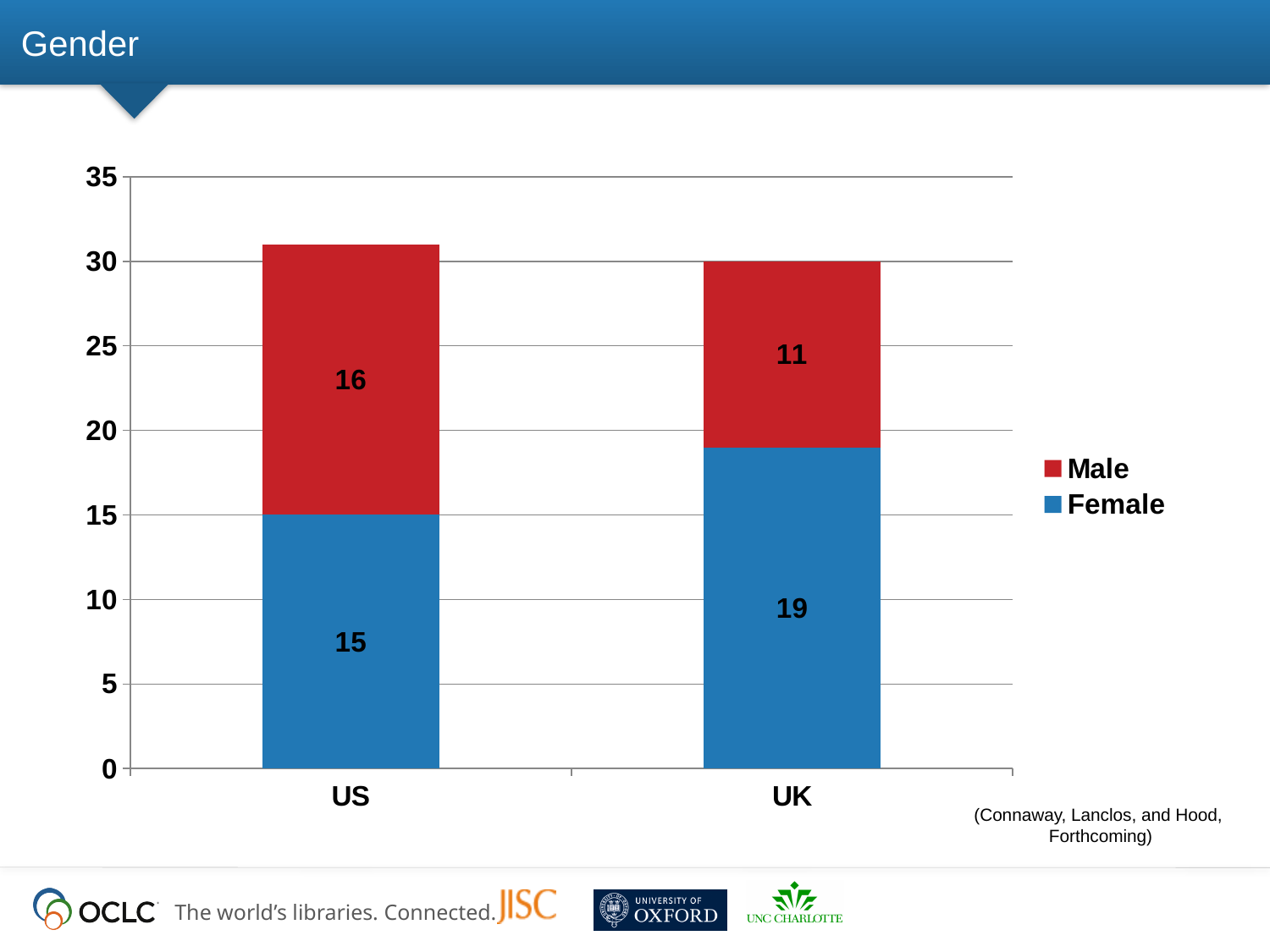
Which category has the lower Male value? UK How many series does the legend list? 2 What is the difference between the Male values for US and UK? 5 What kind of chart is shown on the slide? Stacked bar chart What is the total of the stacked bar for US? 31 What is the Male value for UK? 11 What is the total of the stacked bar for UK? 30 What is the Male value for US? 16 How many categories are shown on the x axis? 2 What is the Female value for UK? 19 Which category has the higher Female value, US or UK? UK What is the Female value for US? 15